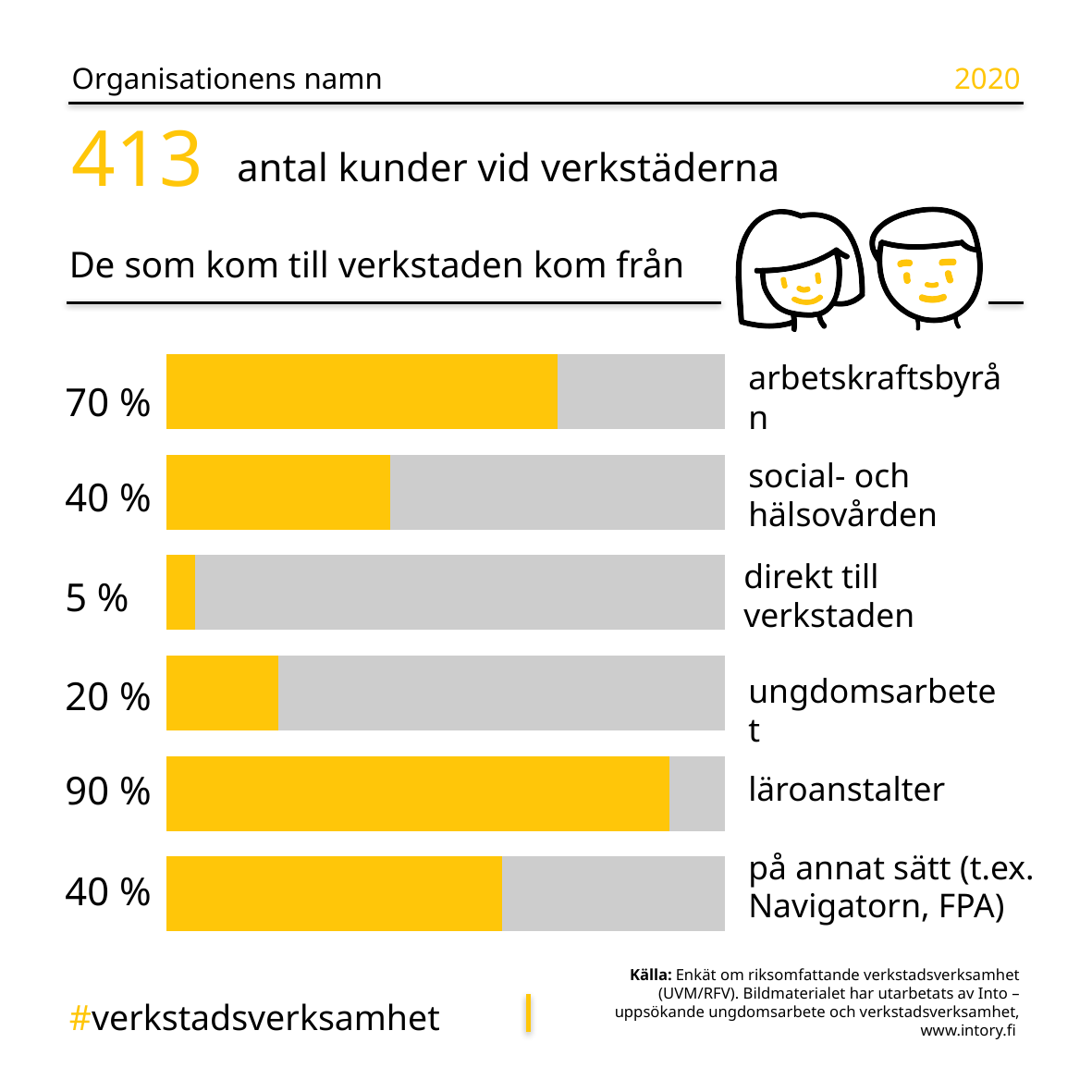
What percentage of customers came directly to the workshop (direkt till verkstaden)? 5 % What percentage of customers came to the workshop from ungdomsarbetet? 20 % What percentage of customers came to the workshop from social- och hälsovården? 40 % What percentage of customers came to the workshop from läroanstalter? 90 % What is the total number of customers at the workshops stated on the slide? 413 What kind of chart is shown on the slide? bar chart What is the difference in percentage points between läroanstalter and arbetskraftsbyrån? 20 Which is larger, the percentage for arbetskraftsbyrån or for ungdomsarbetet? arbetskraftsbyrån Which source has the lowest percentage in the chart? direkt till verkstaden What percentage of customers came to the workshop from arbetskraftsbyrån? 70 % How many categories (sources) are shown in the chart? 6 Which source has the highest percentage in the chart? läroanstalter